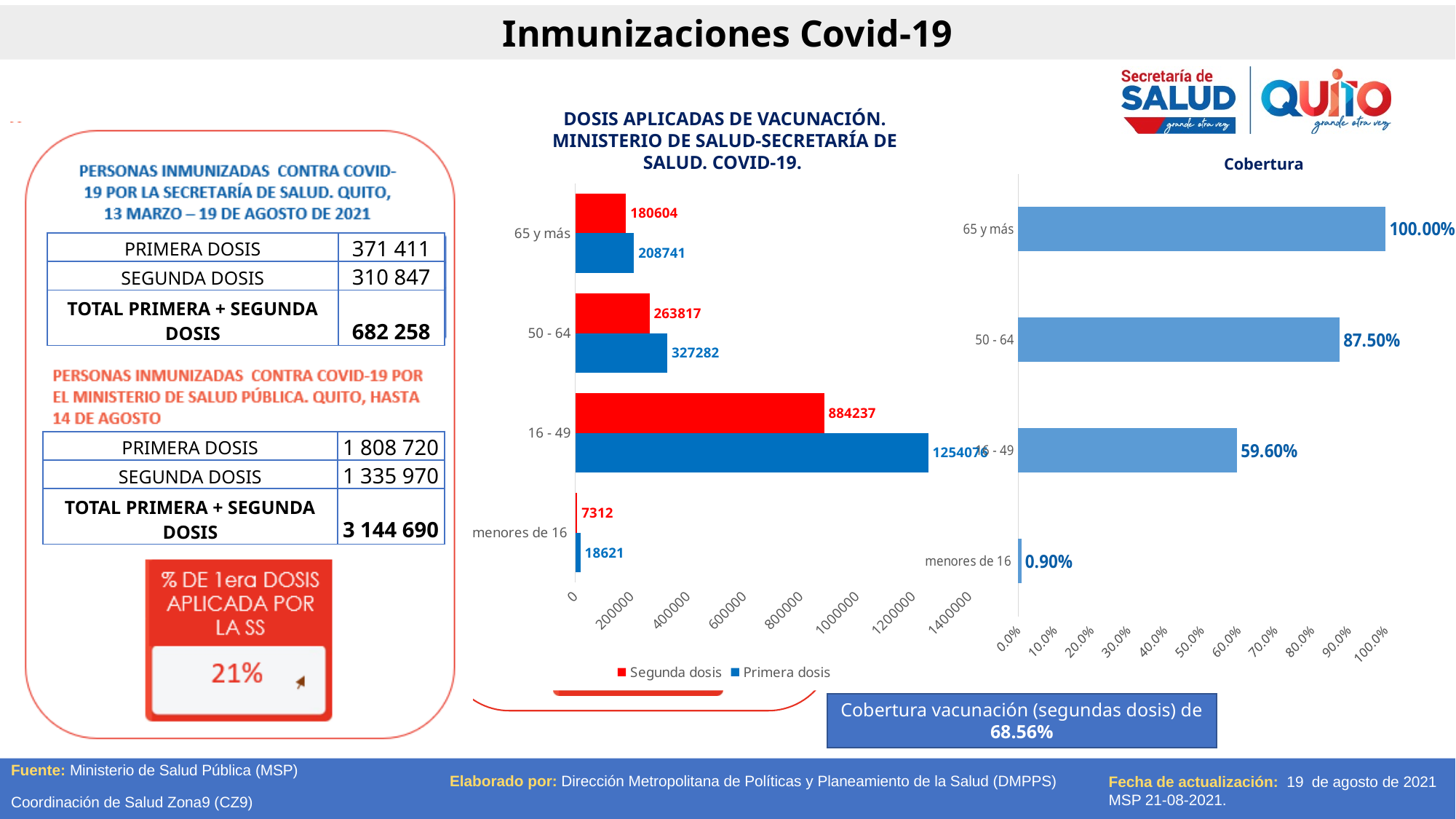
In the 'DOSIS APLICADAS DE VACUNACIÓN' chart, what is the Segunda dosis value for menores de 16? 7312 In the 'Cobertura' chart, how many age groups are shown? 4 In the 'DOSIS APLICADAS DE VACUNACIÓN' chart, which colour represents Segunda dosis? Red In the 'DOSIS APLICADAS DE VACUNACIÓN' chart, what is the difference between the Primera dosis and Segunda dosis values for the 50 - 64 group? 63465 In the 'DOSIS APLICADAS DE VACUNACIÓN' chart, which age group has the lowest Primera dosis value? menores de 16 In the 'DOSIS APLICADAS DE VACUNACIÓN' chart, which age group has the highest Segunda dosis value? 16 - 49 In the 'DOSIS APLICADAS DE VACUNACIÓN' chart, how many series does the legend list? 2 In the 'DOSIS APLICADAS DE VACUNACIÓN' chart, what is the Primera dosis value for the 50 - 64 group? 327282 In the 'Cobertura' chart, what is the value for the 50 - 64 group? 87.50% In the 'DOSIS APLICADAS DE VACUNACIÓN' chart, what is the Segunda dosis value for the 65 y más group? 180604 What type of chart is the 'Cobertura' chart? Bar chart In the 'Cobertura' chart, which age group has the lowest coverage? menores de 16